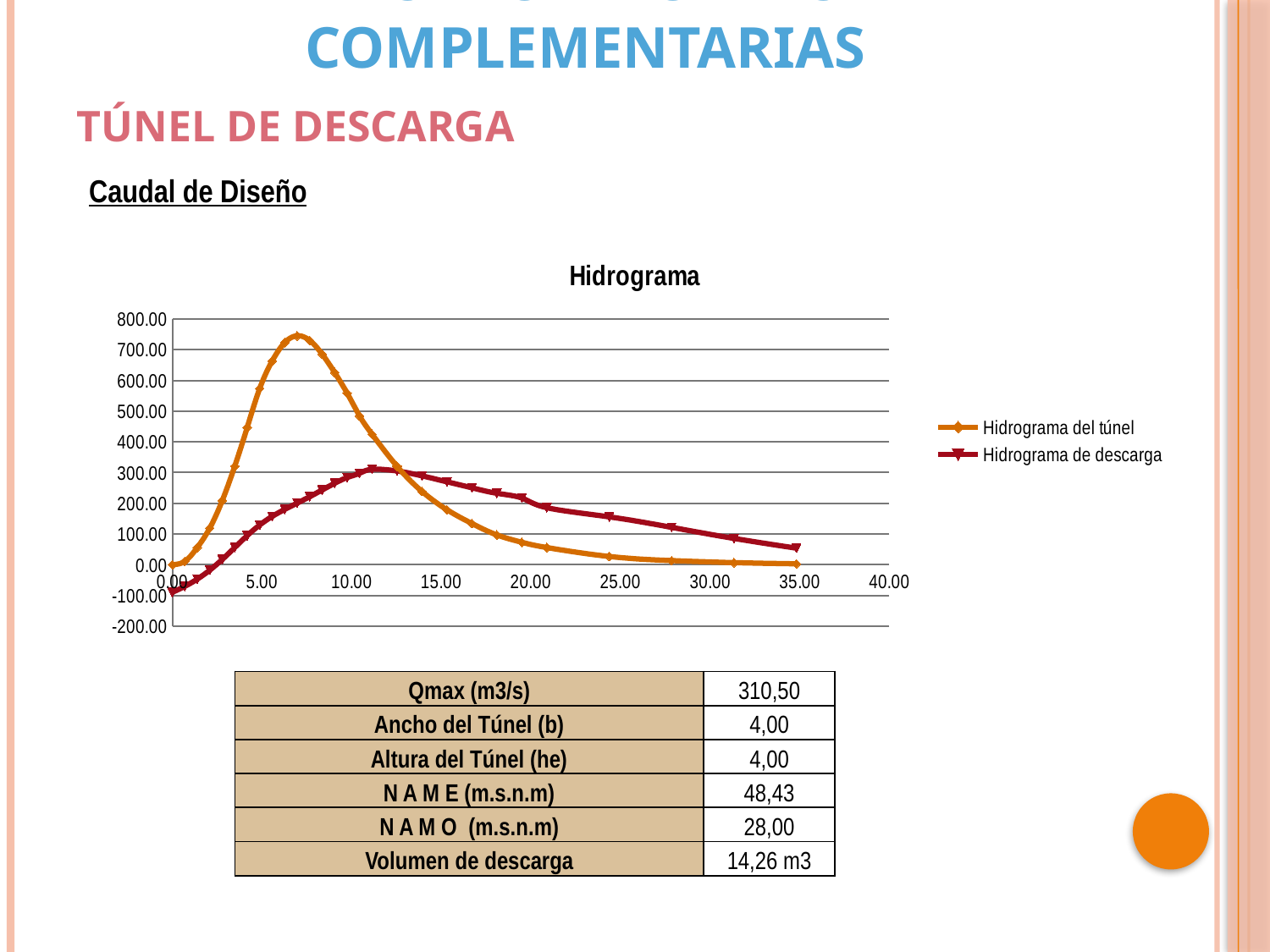
At x = 30.00, which series has the larger value, "Hidrograma del túnel" or "Hidrograma de descarga"? Hidrograma de descarga Between x = 10.00 and x = 35.00, does the "Hidrograma del túnel" series rise or fall? fall What are the two series named in the legend of the "Hidrograma" chart? Hidrograma del túnel and Hidrograma de descarga At x = 20.00, is the value of "Hidrograma de descarga" greater or less than 100.00? greater At x = 5.00, which series has the larger value, "Hidrograma del túnel" or "Hidrograma de descarga"? Hidrograma del túnel Is the peak value of the "Hidrograma del túnel" series greater or less than 700.00? greater At x = 20.00, is the value of "Hidrograma del túnel" greater or less than 100.00? less How many series does the legend of the "Hidrograma" chart list? 2 What kind of chart is shown under the title "Hidrograma"? line chart Which series reaches the higher peak value in the "Hidrograma" chart? Hidrograma del túnel Which colour is used for the "Hidrograma del túnel" series? orange